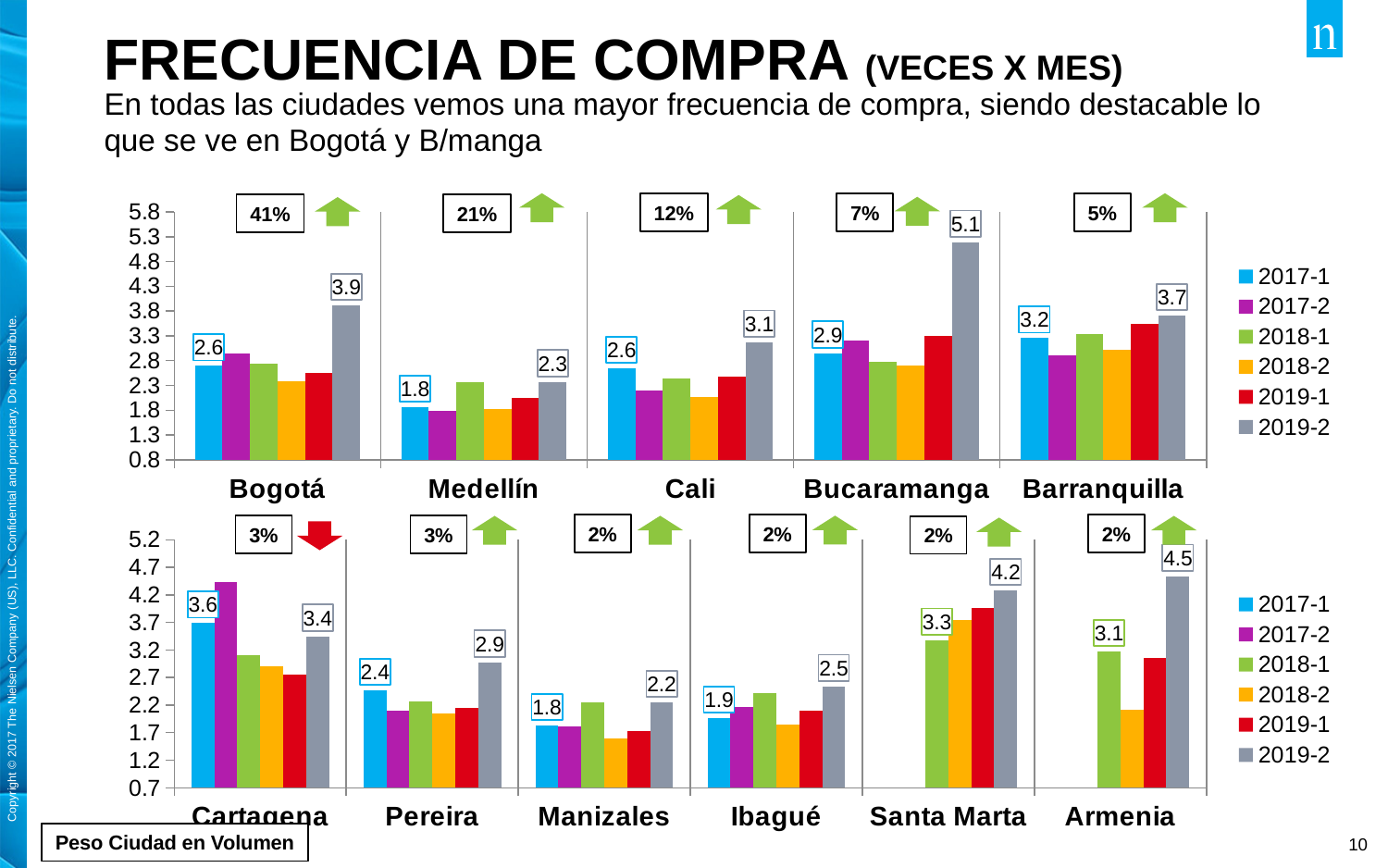
In the bottom chart, what is the 2018-1 value for Santa Marta? 3.3 In the bottom chart, which is larger for Cartagena: the 2017-1 value or the 2019-2 value? 2017-1 In the top chart, what is the difference between the 2019-2 and 2017-1 values for Bogotá? 1.3 How many series does the legend of the top chart list? 6 In the top chart, what is the 2019-2 value for Bucaramanga? 5.1 In the bottom chart, what is the 2019-2 value for Armenia? 4.5 What type of chart is used on this slide? Bar chart In the top chart, which city has the highest 2019-2 value? Bucaramanga In the bottom chart, which city has the lowest 2017-1 value among the labelled values? Manizales In the top chart, what is the 2017-1 value for Medellín? 1.8 How many cities are shown in the bottom chart? 6 In the top chart, is the 2019-1 value for Bucaramanga greater or less than 3.8? less